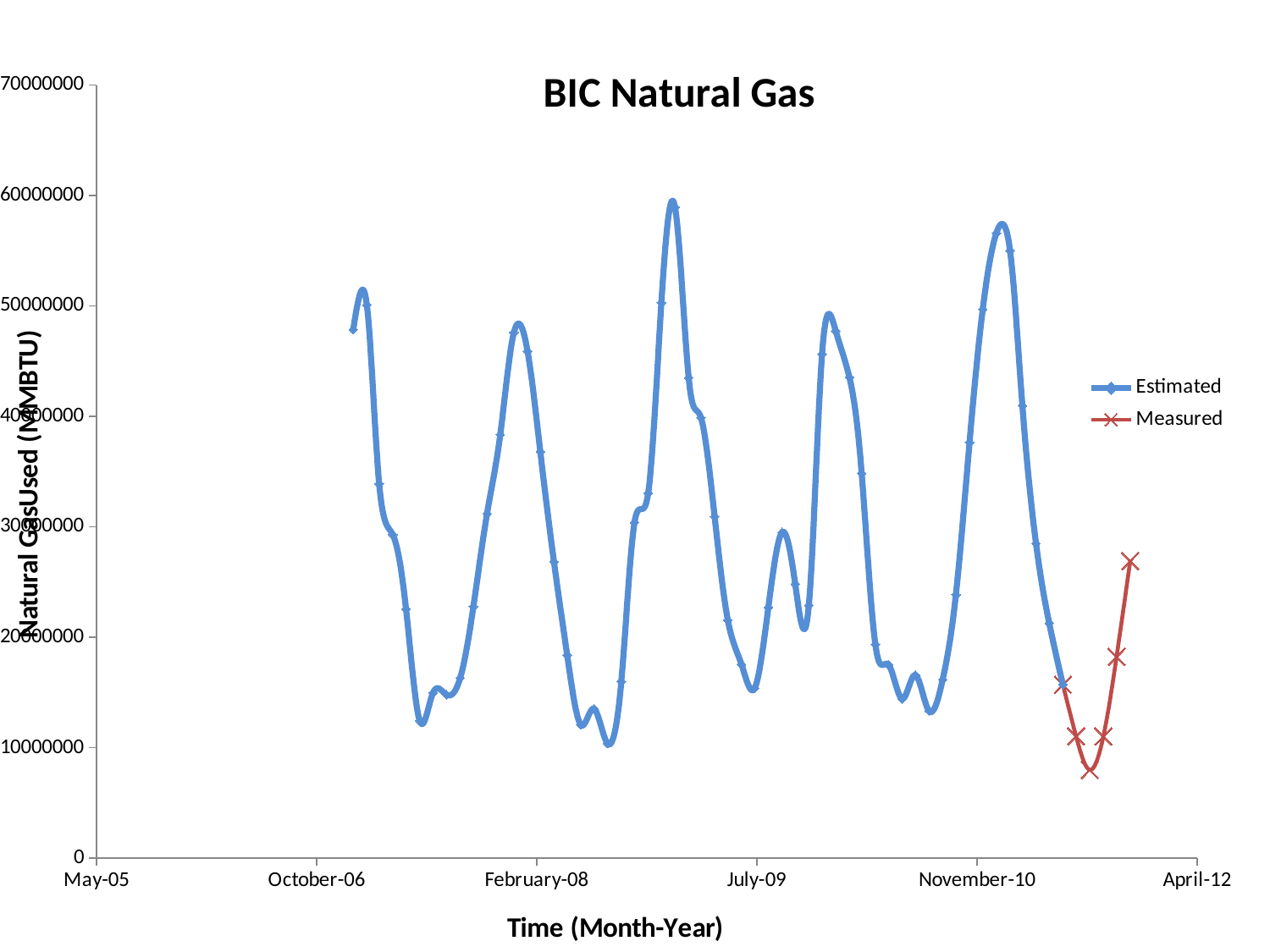
What is the title of the chart? BIC Natural Gas What are the two series named in the legend? Estimated and Measured What is the highest value shown on the y-axis? 70000000 What type of chart is shown on the slide? Line chart How many series does the legend list? 2 Is the last point of the Measured series greater or less than 20000000? greater What is the label of the y-axis? Natural Gas Used (MMBTU) Is the highest peak of the Estimated series greater or less than 50000000? greater Which series reaches higher values, Estimated or Measured? Estimated Which series covers the latest dates on the x-axis? Measured What is the label of the x-axis? Time (Month-Year) Is the lowest point of the Measured series greater or less than 10000000? less